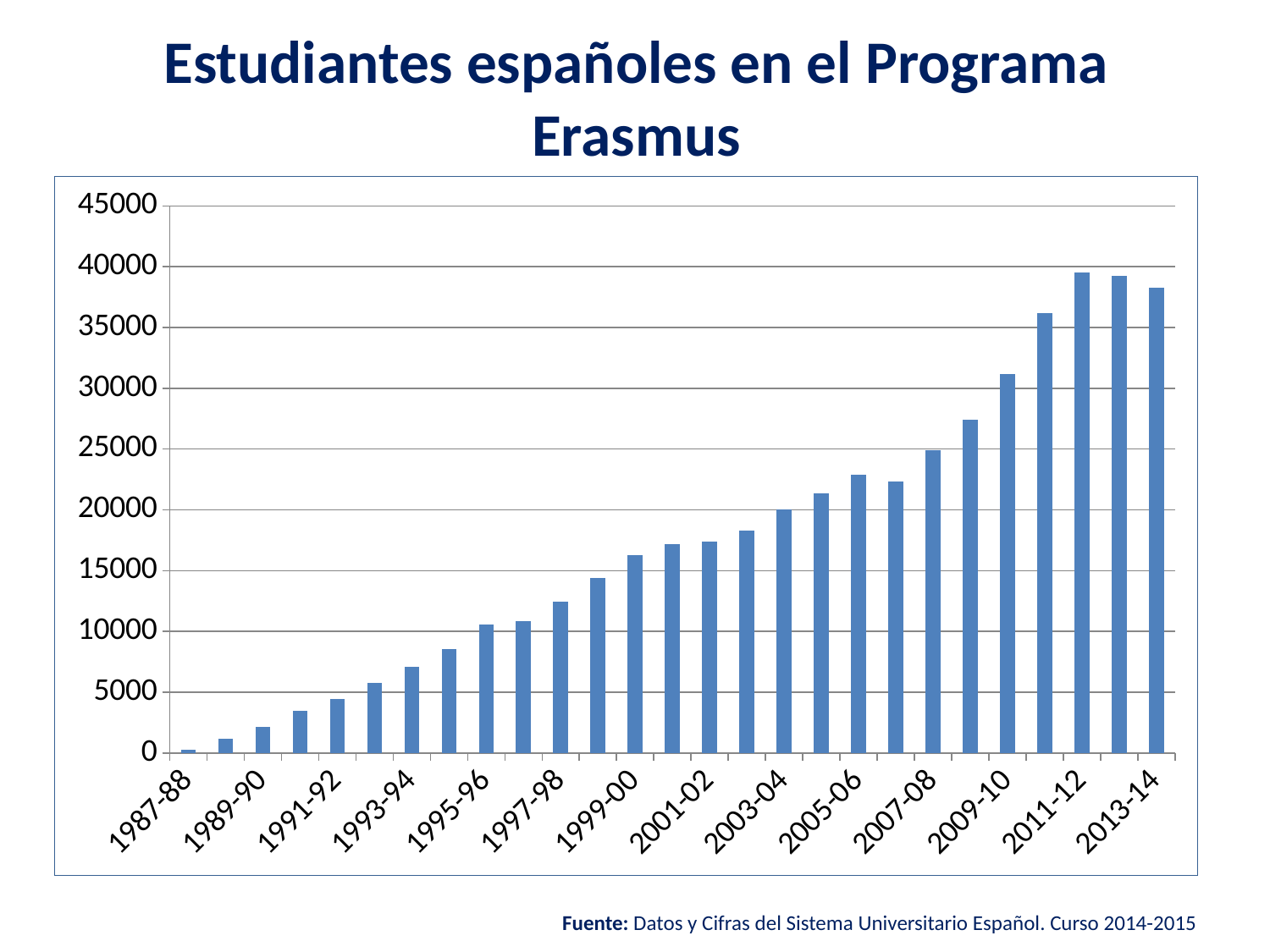
Which is larger, the value for 1989-90 or the value for 1993-94? 1993-94 What kind of chart is shown on the slide? bar chart Is the value for 2009-10 greater or less than 30000? greater Which academic year has the lowest number of students? 1987-88 Is the value for 2001-02 greater or less than 15000? greater Overall, do the values rise or fall from 1987-88 to 2011-12? rise Is the value for 2005-06 greater or less than 20000? greater How many bars (academic years) are plotted in the chart? 27 Which is larger, the value for 2013-14 or the value for 2009-10? 2013-14 What is the title of the chart? Estudiantes españoles en el Programa Erasmus